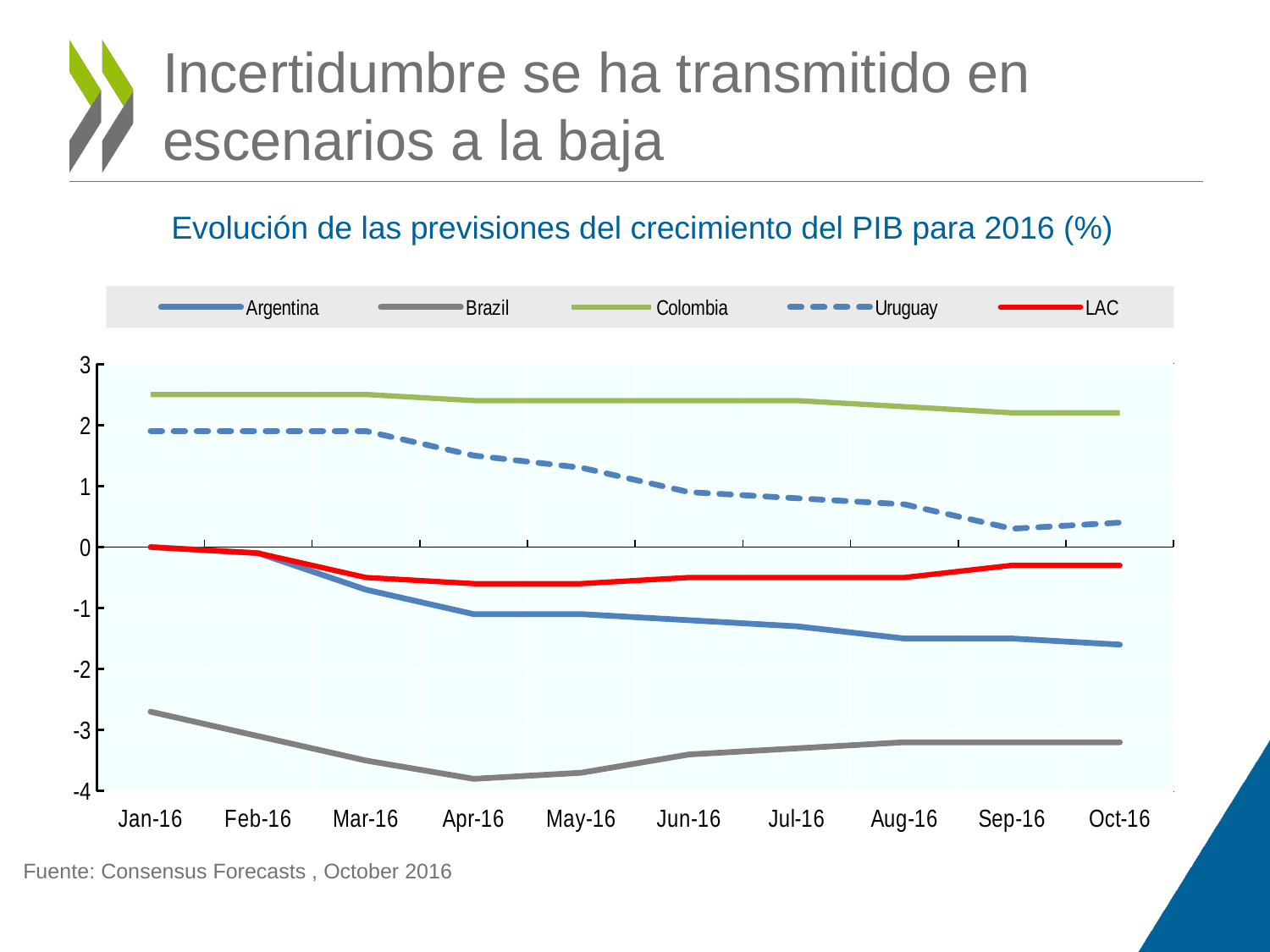
Is the value for Colombia in Jan-16 greater or less than 2? greater Is the value for Uruguay in Oct-16 greater or less than 1? less Is the value for Argentina in Oct-16 greater or less than -1? less Which series has the lowest value in Apr-16? Brazil Which series has the highest value in Oct-16? Colombia How many months are shown along the x axis? 10 How many series does the legend list? 5 Which is larger in Jun-16, the value for Argentina or the value for Brazil? Argentina Does the Uruguay series rise or fall from Jan-16 to Oct-16? fall What kind of chart is shown on the slide? line chart Which series is drawn with a dashed line? Uruguay